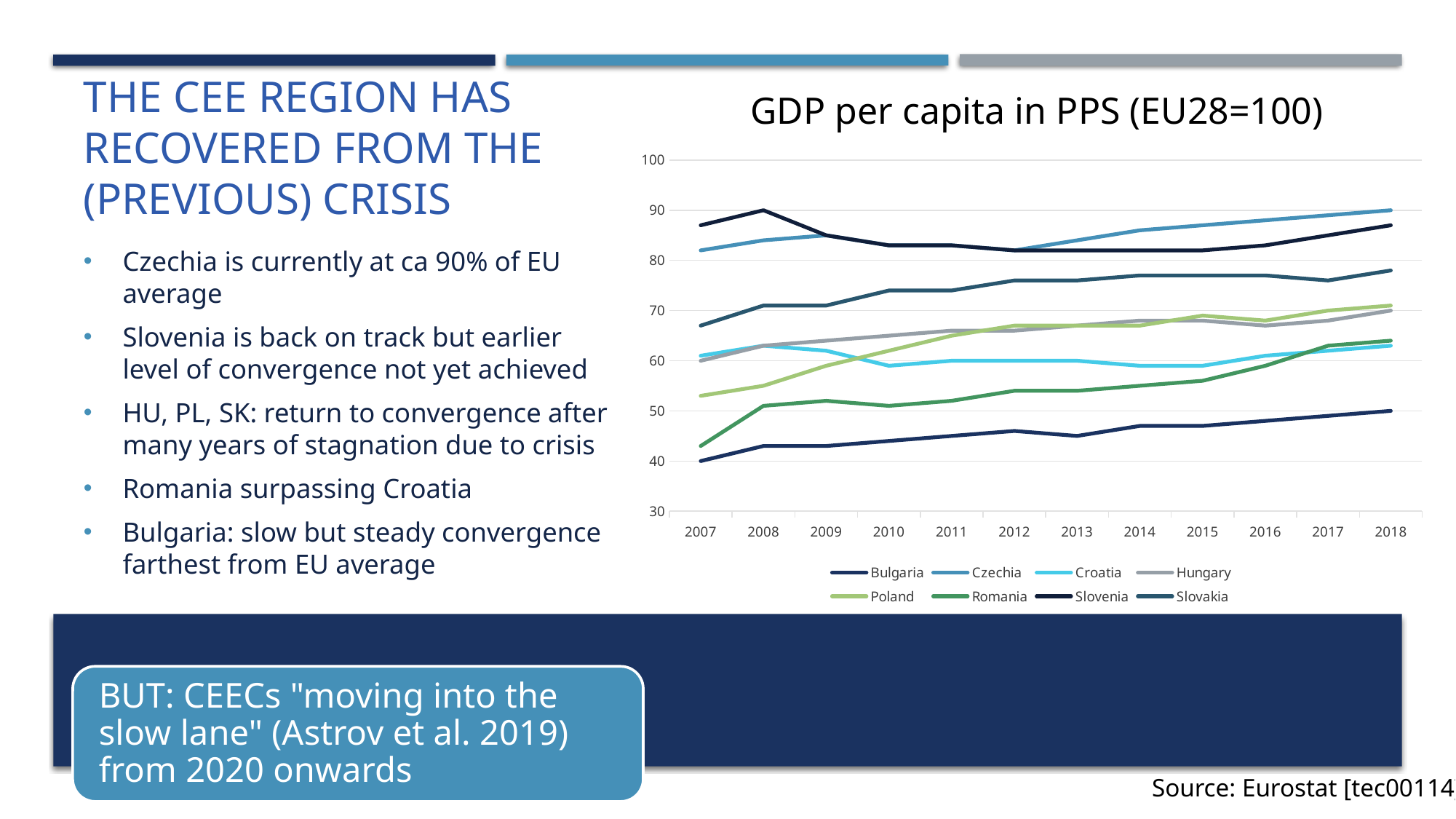
Which country has the highest GDP per capita in PPS in 2007? Slovenia Which country has the highest GDP per capita in PPS in 2018? Czechia What is the value for Bulgaria in 2007? 40 Is the value for Romania in 2007 greater or less than 50? less In 2018, which is larger: the value for Czechia or the value for Slovenia? Czechia What is the value for Slovenia in 2008? 90 Is the value for Slovakia in 2018 greater or less than 80? less How many years are shown on the x axis of the chart? 12 Does the line for Bulgaria rise or fall from 2007 to 2018? rise How many countries does the legend of the chart list? 8 What kind of chart is shown on the slide? line chart Which country has the lowest GDP per capita in PPS in 2018? Bulgaria